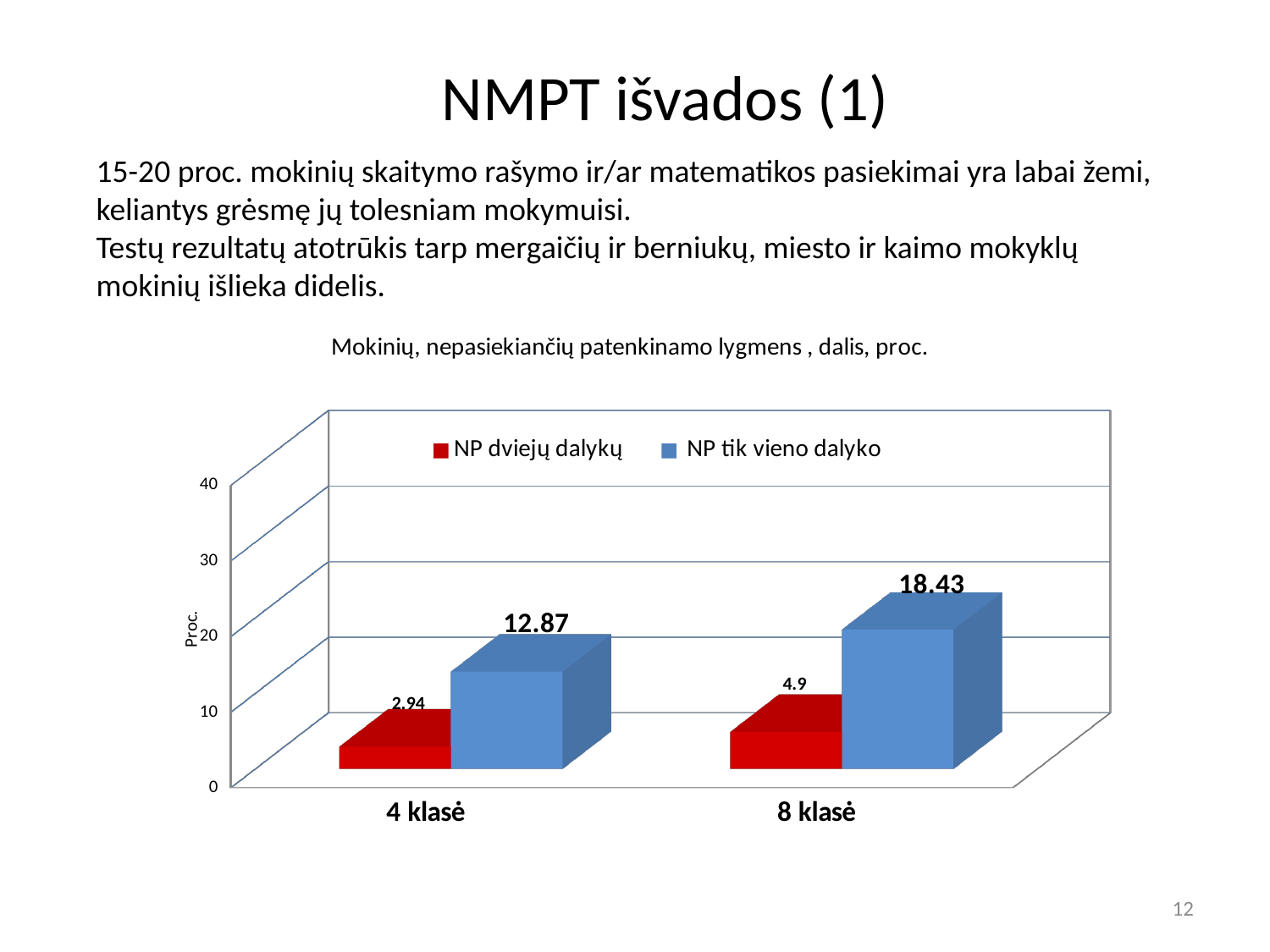
Which is larger in 4 klasė: 'NP dviejų dalykų' or 'NP tik vieno dalyko'? NP tik vieno dalyko What is the value for 'NP dviejų dalykų' in 8 klasė? 4.9 Which category has the lowest value for 'NP dviejų dalykų'? 4 klasė What is the value for 'NP tik vieno dalyko' in 8 klasė? 18.43 Which category has the highest value for 'NP tik vieno dalyko'? 8 klasė What is the value for 'NP dviejų dalykų' in 4 klasė? 2.94 What kind of chart is shown on the slide? Bar chart What is the difference between the 'NP tik vieno dalyko' values for 8 klasė and 4 klasė? 5.56 What is the value for 'NP tik vieno dalyko' in 4 klasė? 12.87 How many series does the legend list? 2 What is the difference between 'NP tik vieno dalyko' and 'NP dviejų dalykų' in 8 klasė? 13.53 How many categories are shown on the x axis? 2